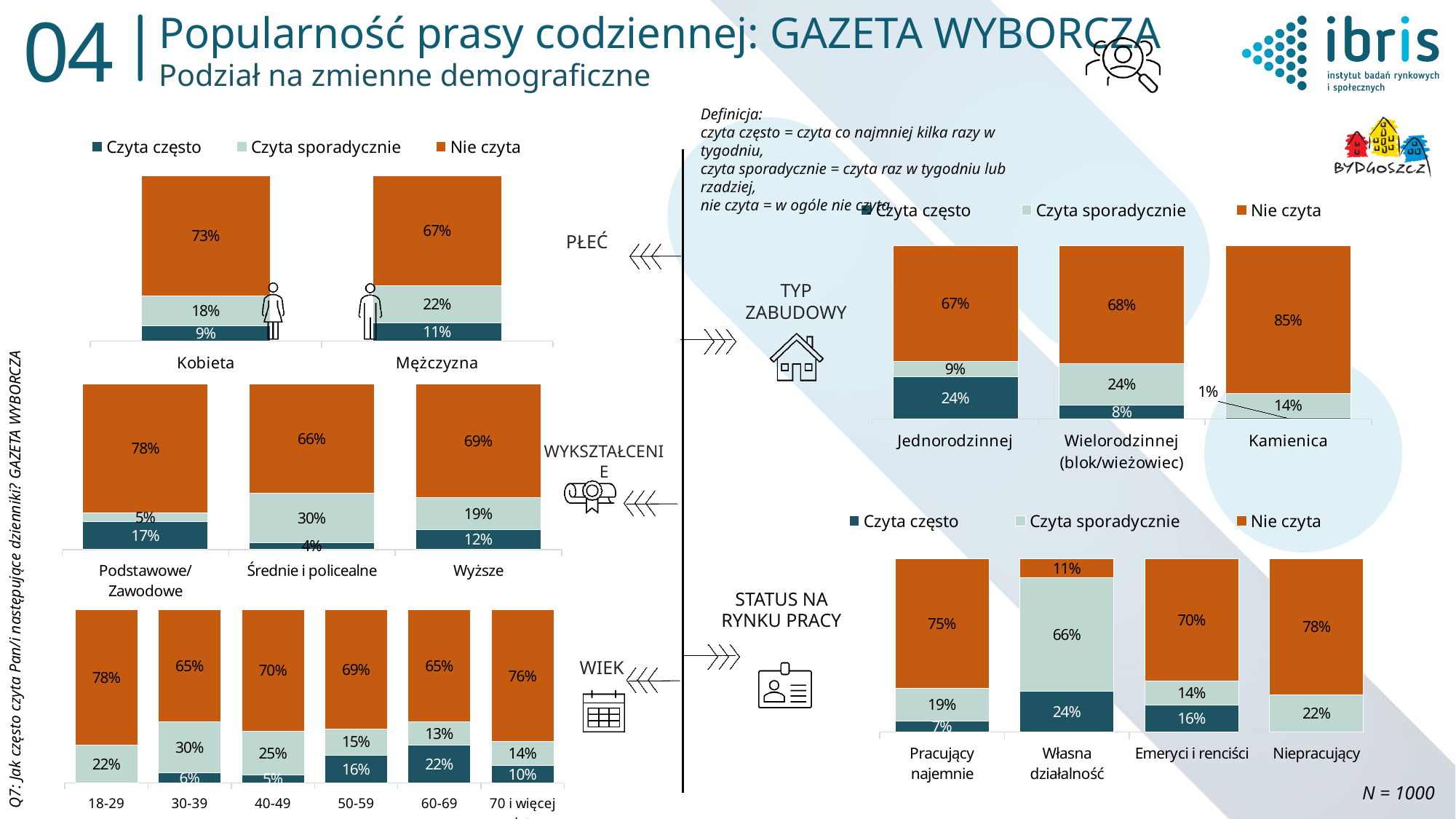
How many series does the legend of the PŁEĆ chart list? 3 In the WYKSZTAŁCENIE chart, what is the difference between the 'Nie czyta' values for Podstawowe/Zawodowe and Średnie i policealne? 12 percentage points In the WYKSZTAŁCENIE chart, which education category has the highest 'Czyta sporadycznie' value? Średnie i policealne In the WIEK chart, which age group has the highest 'Czyta często' value? 60-69 In the WIEK chart, is the 'Czyta sporadycznie' value larger for 30-39 or for 50-59? 30-39 In the PŁEĆ chart, what is the 'Czyta często' value for Mężczyzna? 11% In the TYP ZABUDOWY chart, which housing type has the lowest 'Czyta często' value? Kamienica In the WIEK chart, how many age categories are shown? 6 In the PŁEĆ chart, what is the 'Nie czyta' value for Kobieta? 73% In the STATUS NA RYNKU PRACY chart, what is the 'Czyta sporadycznie' value for Własna działalność? 66% In the STATUS NA RYNKU PRACY chart, what is the total of the stacked bar for Emeryci i renciści? 100% In the TYP ZABUDOWY chart, what is the 'Nie czyta' value for Kamienica? 85%